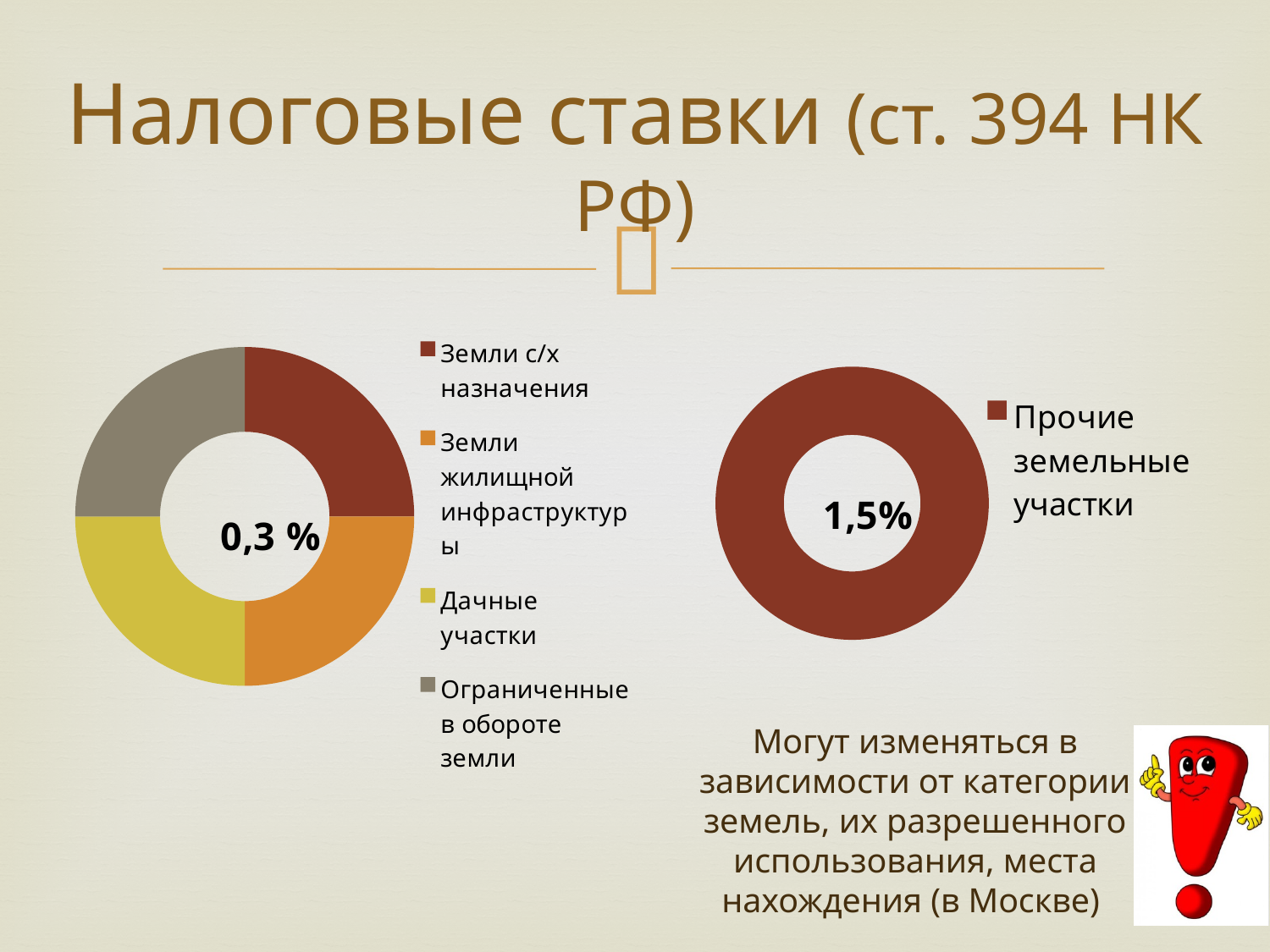
What rate is printed in the centre of the right chart? 1,5% In the left chart, which category is shown in yellow? Дачные участки What rate is printed in the centre of the left chart? 0,3 % How many categories does the legend of the left chart list? 4 What kind of chart is the right chart on the slide? doughnut chart What is the difference between the rate in the centre of the right chart (1,5%) and the rate in the centre of the left chart (0,3 %)? 1,2% What is the only legend entry of the right chart? Прочие земельные участки How many categories does the legend of the right chart list? 1 Which chart shows the higher tax rate in its centre, the left chart or the right chart? the right chart What kind of chart is the left chart on the slide? doughnut chart